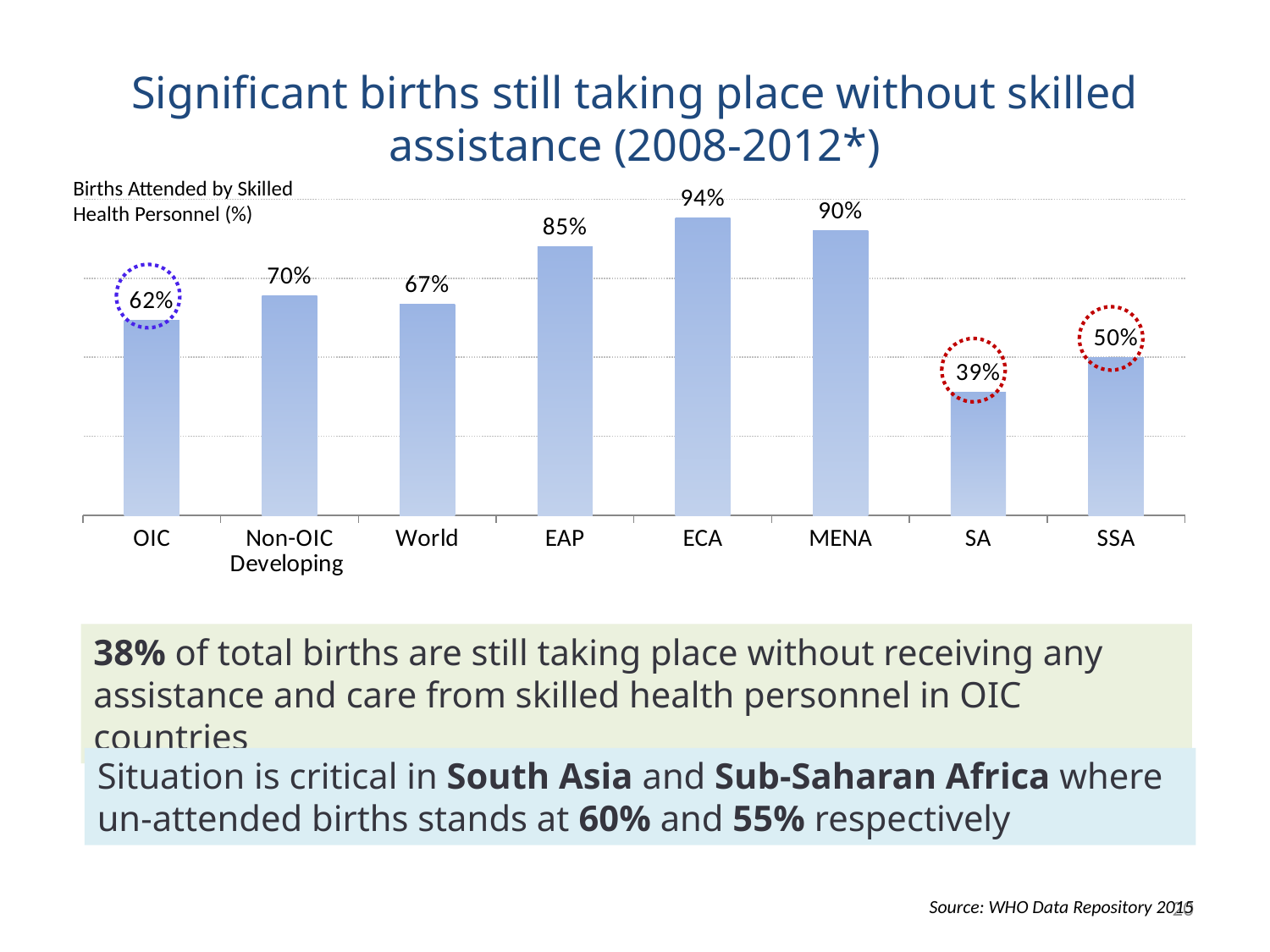
Which is larger, the value for MENA or the value for EAP? MENA Which category has the highest value? ECA What is the value for ECA? 94% How many categories are shown in the chart? 8 What is the value for OIC in the chart? 62% What is the difference between the values for ECA and SA? 55% What is the value for SA? 39% Which category has the lowest value? SA What is the difference between the values for World and OIC? 5% What is the axis label shown at the top left of the chart? Births Attended by Skilled Health Personnel (%) What kind of chart is shown on the slide? Bar chart What is the value for Non-OIC Developing? 70%